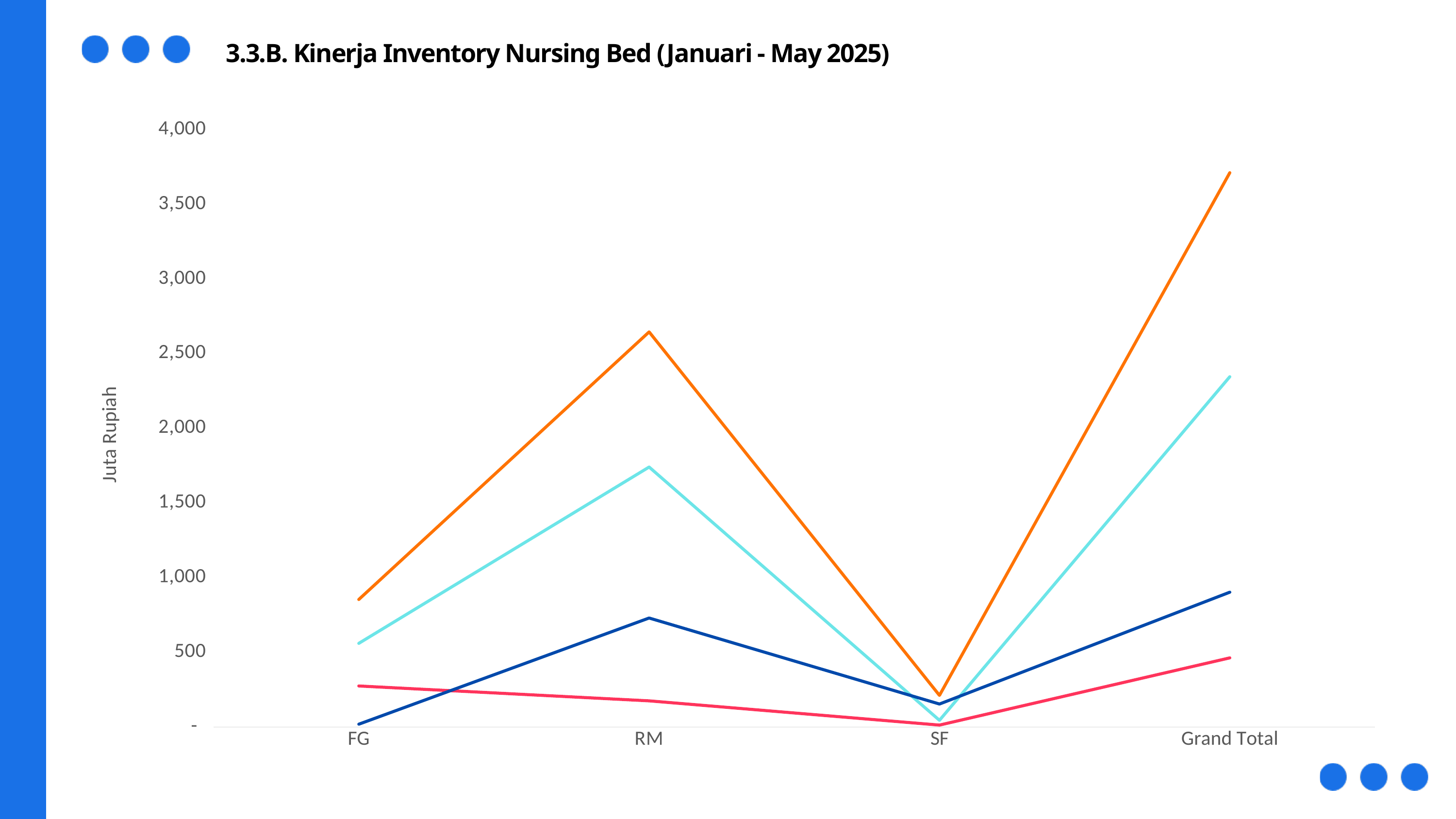
Is the value of the light blue line at RM greater or less than 2,000? less For the orange line, which category has the lowest value? SF How many lines are plotted on the chart? 4 Is the value of the dark blue line at Grand Total greater or less than 1,000? less Is the value of the orange line at Grand Total greater or less than 3,500? greater What kind of chart is shown on the slide? line chart What is the title of the chart? 3.3.B. Kinerja Inventory Nursing Bed (Januari - May 2025) For the orange line, which category has the highest value? Grand Total What is the label on the vertical axis? Juta Rupiah How many categories are shown on the x axis? 4